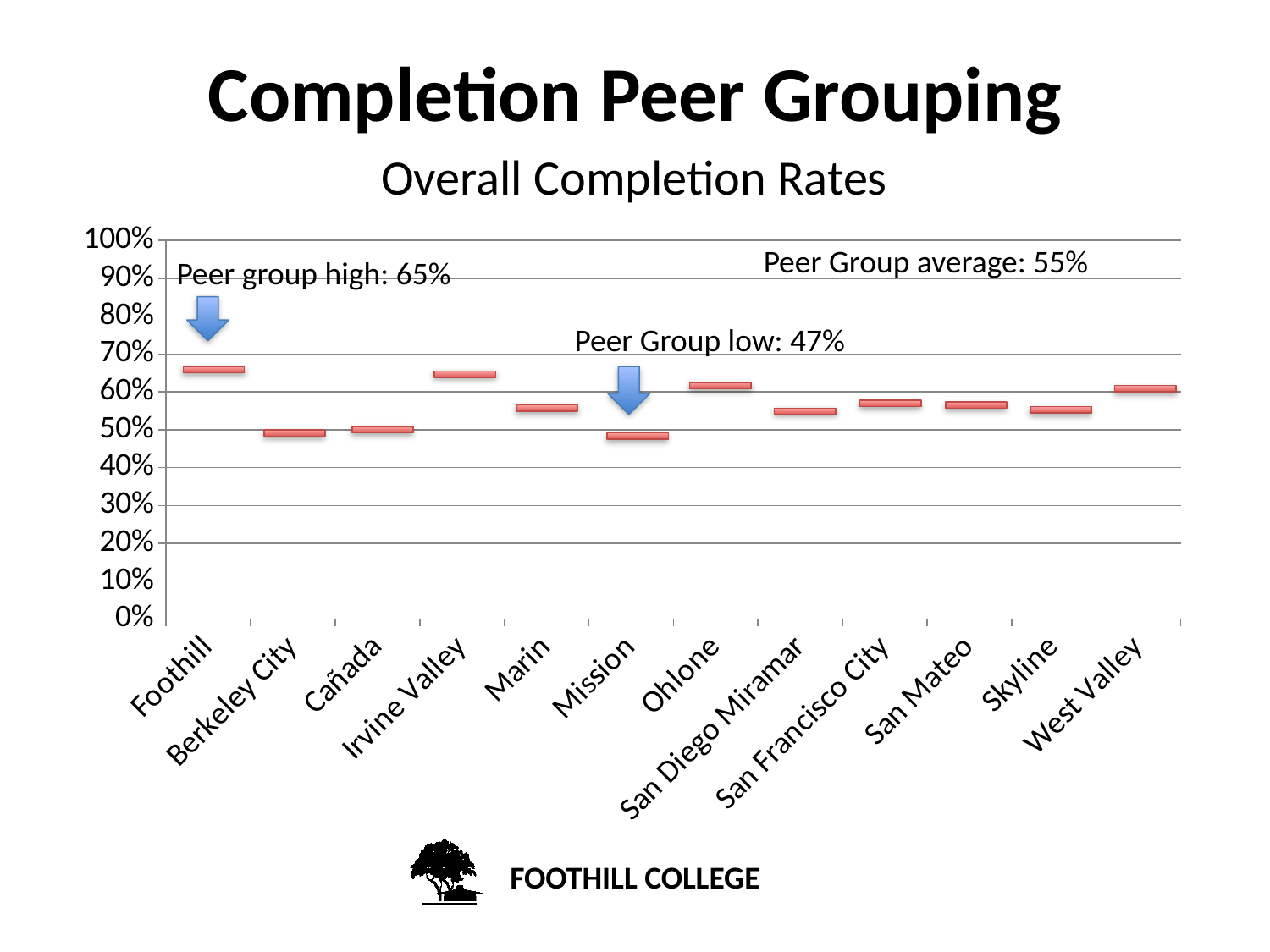
Which college has the lowest overall completion rate? Mission How many colleges are shown on the x axis? 12 What is the completion rate for Foothill, labelled as the peer group high? 65% Is the value for Skyline greater or less than 60%? less Which has a higher completion rate, Irvine Valley or Marin? Irvine Valley Is the value for Marin greater or less than 50%? greater What is the peer group average completion rate stated on the chart? 55% What is the difference between the peer group high and the peer group low completion rates? 18 percentage points What is the title of the chart? Overall Completion Rates What is the completion rate for Mission, labelled as the peer group low? 47% Which has a higher completion rate, Ohlone or Mission? Ohlone Which college has the highest overall completion rate? Foothill